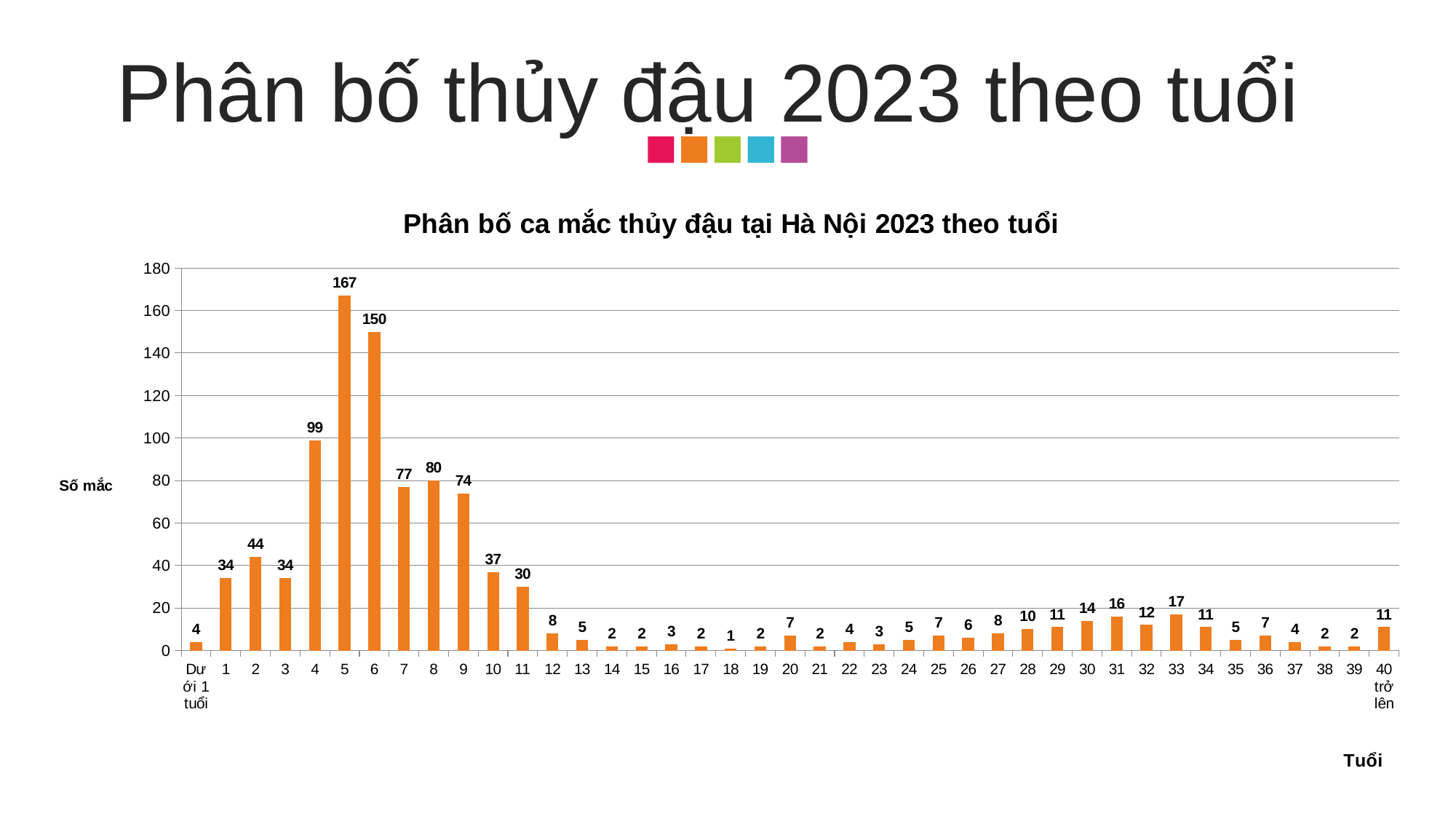
How many cases (Số mắc) are shown for age 5? 167 How many cases are shown for age 8? 80 Which age category has the highest number of cases? 5 Is the value for age 7 greater or less than 60? greater What is the title of the chart? Phân bố ca mắc thủy đậu tại Hà Nội 2023 theo tuổi What is the difference in cases between age 4 and age 3? 65 Which age category has the lowest number of cases? 18 Which has more cases, age 2 or age 10? Age 2 How many cases are shown for the category '40 trở lên'? 11 What type of chart is shown on the slide? Bar chart What is the difference in cases between age 5 and age 6? 17 How many age categories are shown on the x axis? 41